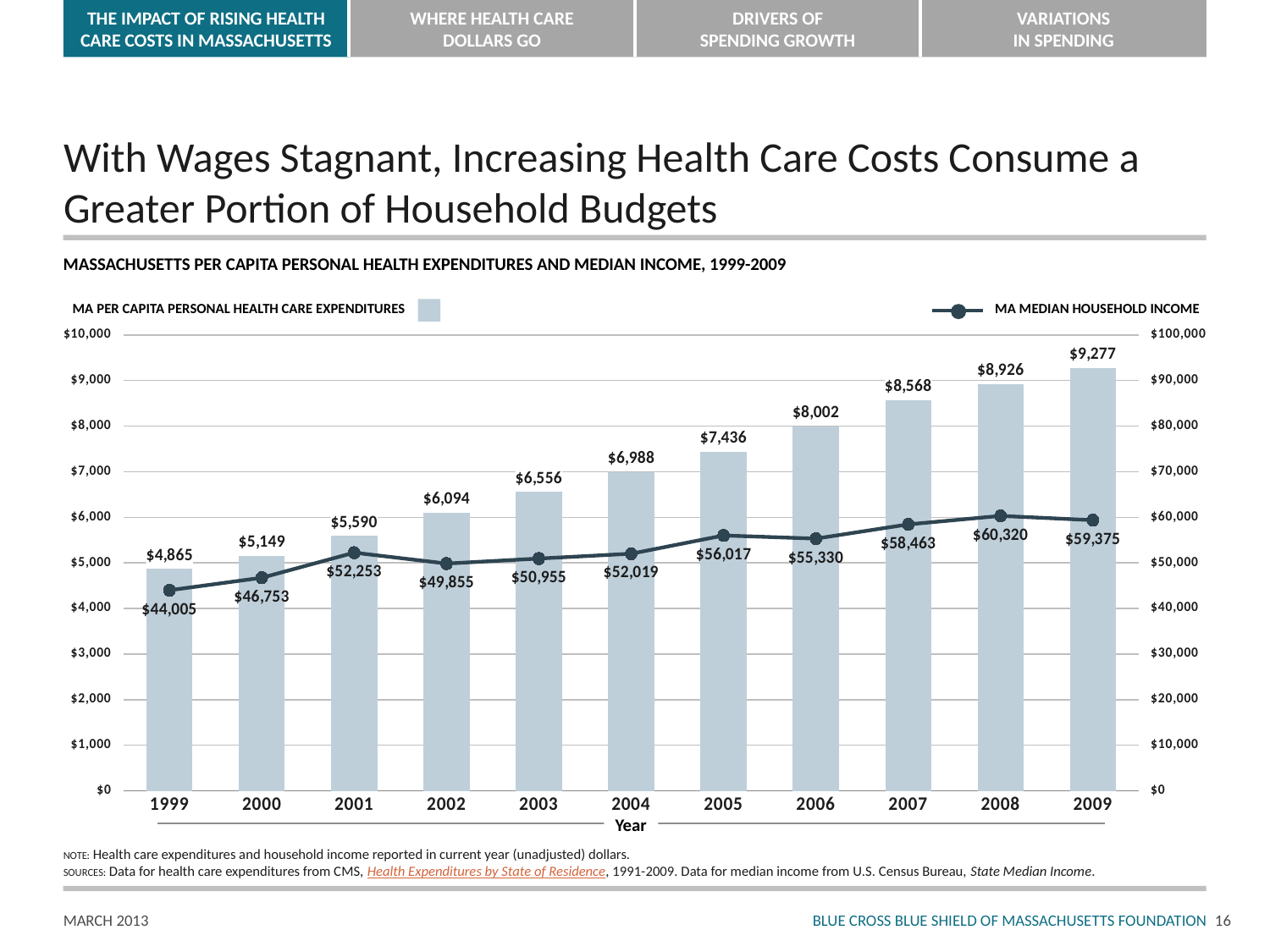
What is the overall trend of MA per capita personal health care expenditures from 1999 to 2009? Rising Which year had a higher MA median household income, 2001 or 2002? 2001 What was the MA median household income in 2002? $49,855 In which year was the MA median household income highest? 2008 What was the MA per capita personal health care expenditure in 2004? $6,988 How many series does the chart's legend list? 2 By how much did the MA per capita personal health care expenditure increase from 1999 to 2009? $4,412 What is the difference between the MA median household income in 2008 and in 2009? $945 What is the title of the chart on the slide? Massachusetts Per Capita Personal Health Expenditures and Median Income, 1999-2009 In which year was the MA median household income lowest? 1999 How many years are shown on the x axis of the chart? 11 In which year was the MA per capita personal health care expenditure highest? 2009